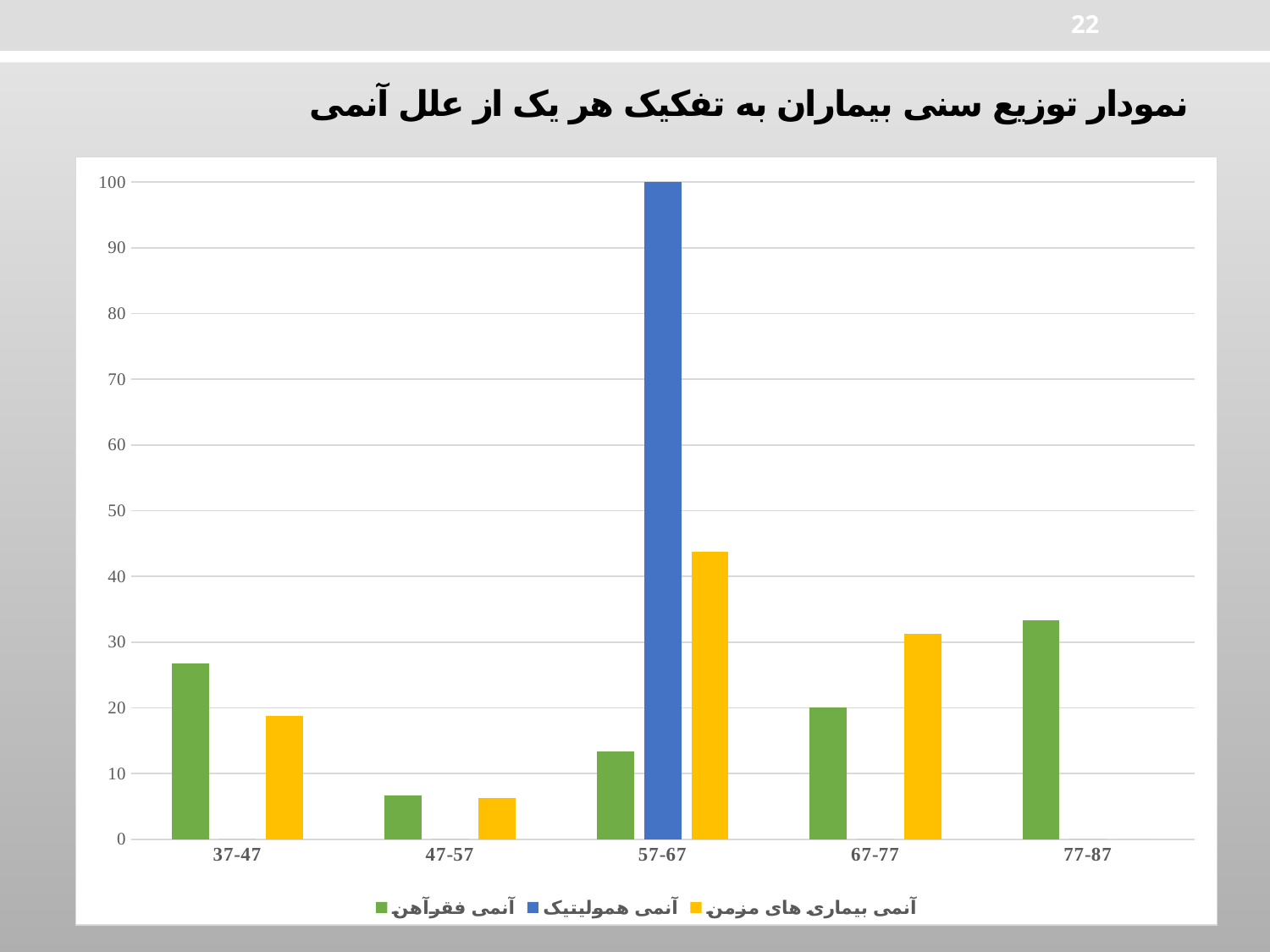
Is the value of آنمی فقرآهن (iron deficiency anemia) for the 37-47 age group greater or less than 20? greater What is the value of the آنمی همولیتیک (hemolytic anemia) bar for the 57-67 age group? 100 In the 37-47 age group, which series has the larger value: آنمی فقرآهن or آنمی بیماری های مزمن? آنمی فقرآهن Which age group contains the tallest bar in the chart? 57-67 What kind of chart is shown on the slide? bar chart Which age group has the lowest value for آنمی فقرآهن (iron deficiency anemia)? 47-57 How many series does the legend list? 3 How many age-group categories are shown on the x axis? 5 Is the value of آنمی فقرآهن (iron deficiency anemia) for the 47-57 age group greater or less than 10? less Is the value of آنمی بیماری های مزمن (anemia of chronic disease) for the 57-67 age group greater or less than 40? greater In the 67-77 age group, which series has the larger value: آنمی فقرآهن or آنمی بیماری های مزمن? آنمی بیماری های مزمن What colour represents آنمی همولیتیک (hemolytic anemia) in the legend? blue